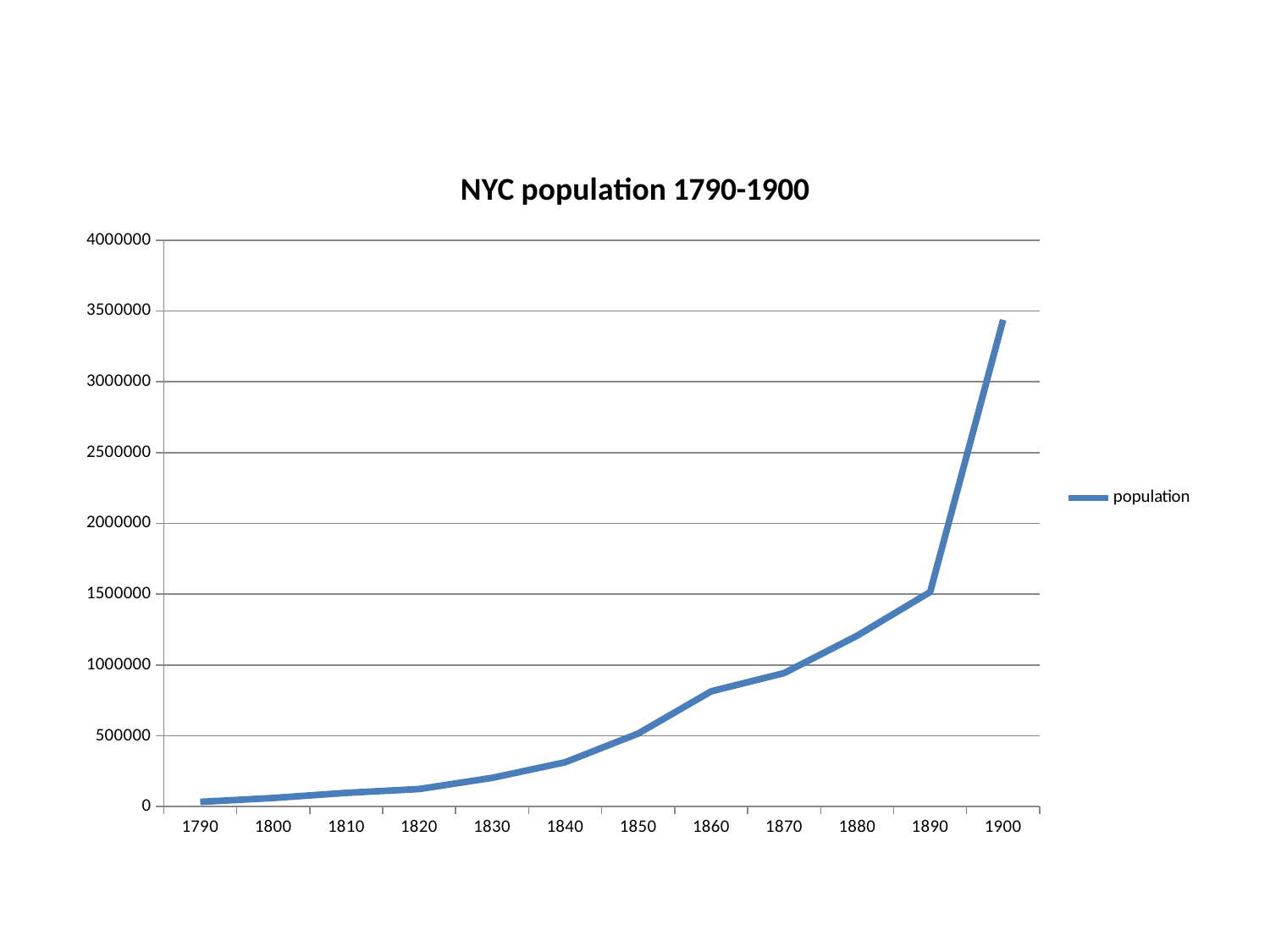
Is the population value for 1870 greater or less than 1000000? less Which year has the highest population value? 1900 What is the name of the series shown in the legend? population What kind of chart is shown on the slide? line chart Is the population value for 1900 greater or less than 3000000? greater How many years are marked along the x axis? 12 Does the population rise or fall from 1790 to 1900? rise Which year has the lowest population value? 1790 Is the population value for 1890 greater or less than 2000000? less How many series does the legend list? 1 Which year has the larger population value, 1860 or 1880? 1880 What is the title of the chart? NYC population 1790-1900